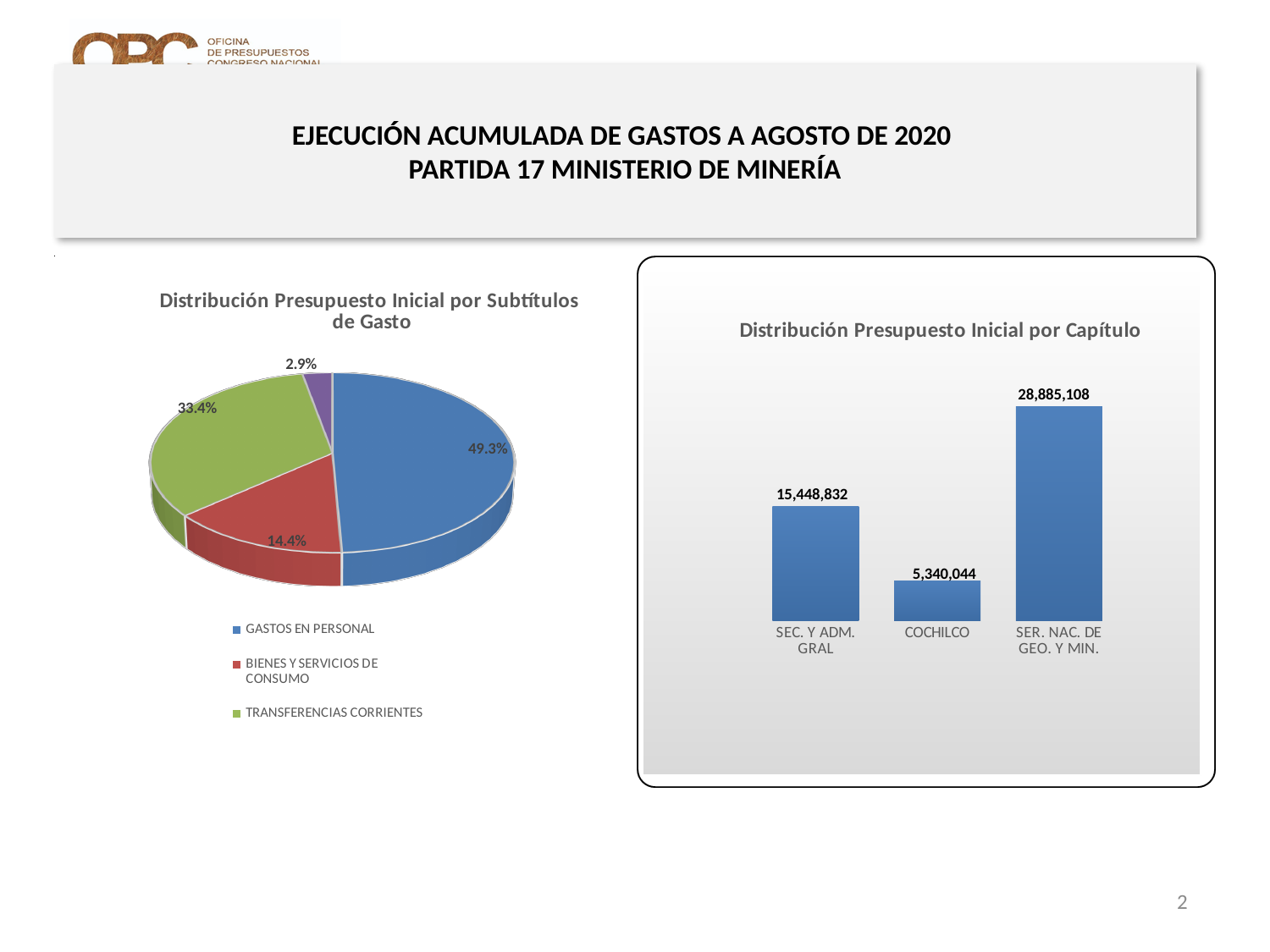
How many entries does the legend of the pie chart 'Distribución Presupuesto Inicial por Subtítulos de Gasto' list? 3 In the bar chart 'Distribución Presupuesto Inicial por Capítulo', what is the value for COCHILCO? 5,340,044 In the pie chart 'Distribución Presupuesto Inicial por Subtítulos de Gasto', which is larger: BIENES Y SERVICIOS DE CONSUMO or TRANSFERENCIAS CORRIENTES? TRANSFERENCIAS CORRIENTES What kind of chart is 'Distribución Presupuesto Inicial por Capítulo'? Bar chart In the bar chart 'Distribución Presupuesto Inicial por Capítulo', which category has the highest value? SER. NAC. DE GEO. Y MIN. In the bar chart 'Distribución Presupuesto Inicial por Capítulo', which category has the lowest value? COCHILCO In the bar chart 'Distribución Presupuesto Inicial por Capítulo', which is larger: SEC. Y ADM. GRAL or COCHILCO? SEC. Y ADM. GRAL In the pie chart 'Distribución Presupuesto Inicial por Subtítulos de Gasto', what share does GASTOS EN PERSONAL have? 49.3% How many categories are shown in the bar chart 'Distribución Presupuesto Inicial por Capítulo'? 3 In the bar chart 'Distribución Presupuesto Inicial por Capítulo', what is the difference between SER. NAC. DE GEO. Y MIN. and SEC. Y ADM. GRAL? 13,436,276 In the bar chart 'Distribución Presupuesto Inicial por Capítulo', what is the value for SEC. Y ADM. GRAL? 15,448,832 In the pie chart 'Distribución Presupuesto Inicial por Subtítulos de Gasto', what share does TRANSFERENCIAS CORRIENTES have? 33.4%